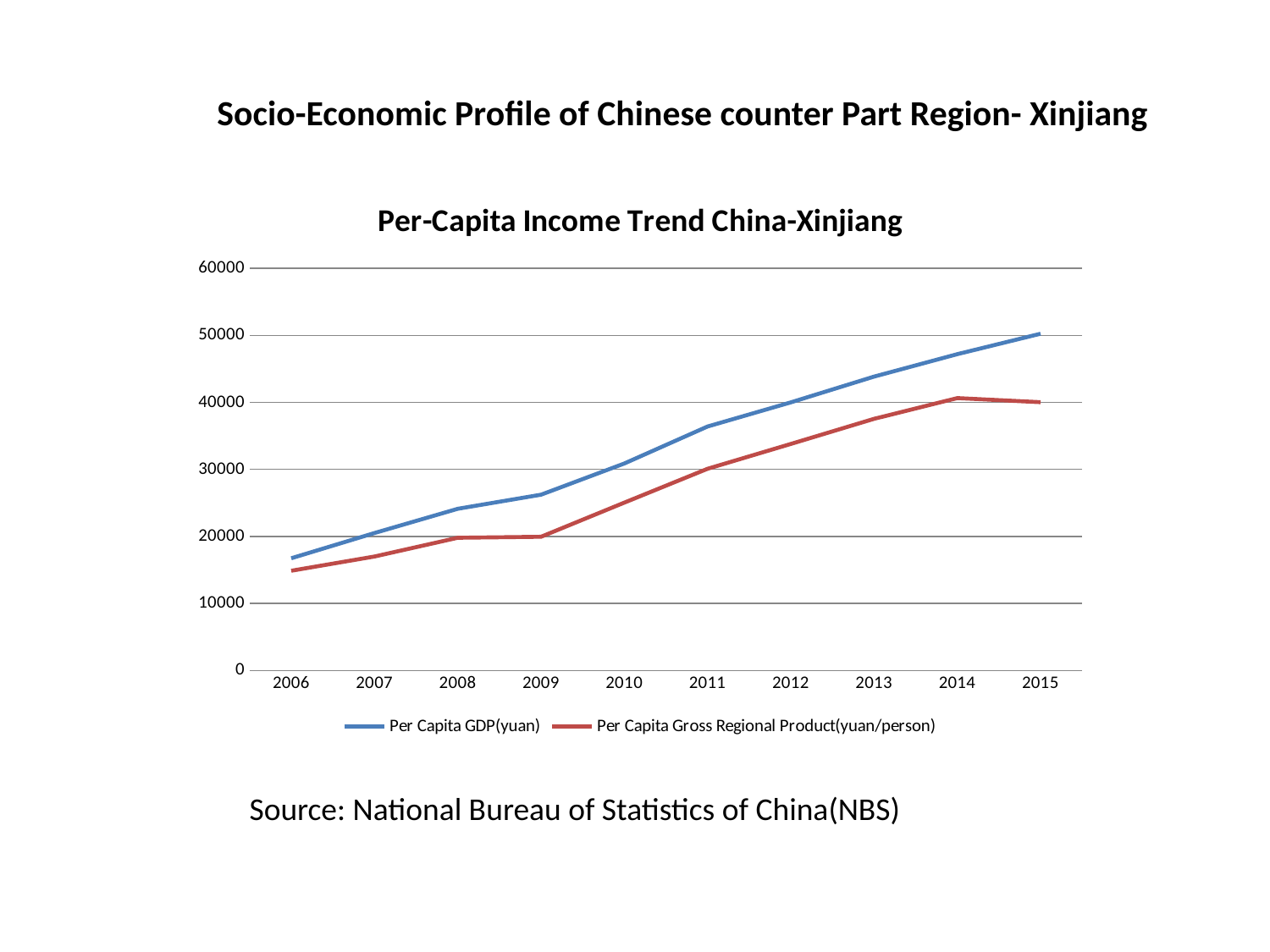
In which year is Per Capita GDP(yuan) lowest? 2006 Is the value for Per Capita GDP(yuan) in 2011 greater or less than 30000? greater In 2015, which is larger: Per Capita GDP(yuan) or Per Capita Gross Regional Product(yuan/person)? Per Capita GDP(yuan) Is the value for Per Capita Gross Regional Product(yuan/person) in 2012 greater or less than 30000? greater Is the value for Per Capita GDP(yuan) in 2006 greater or less than 20000? less What kind of chart is shown on the slide? line chart What is the title of the chart? Per-Capita Income Trend China-Xinjiang How many series does the legend list? 2 How many years are plotted along the x axis? 10 Which series is drawn in red? Per Capita Gross Regional Product(yuan/person) In which year is Per Capita Gross Regional Product(yuan/person) lowest? 2006 In which year is Per Capita GDP(yuan) highest? 2015